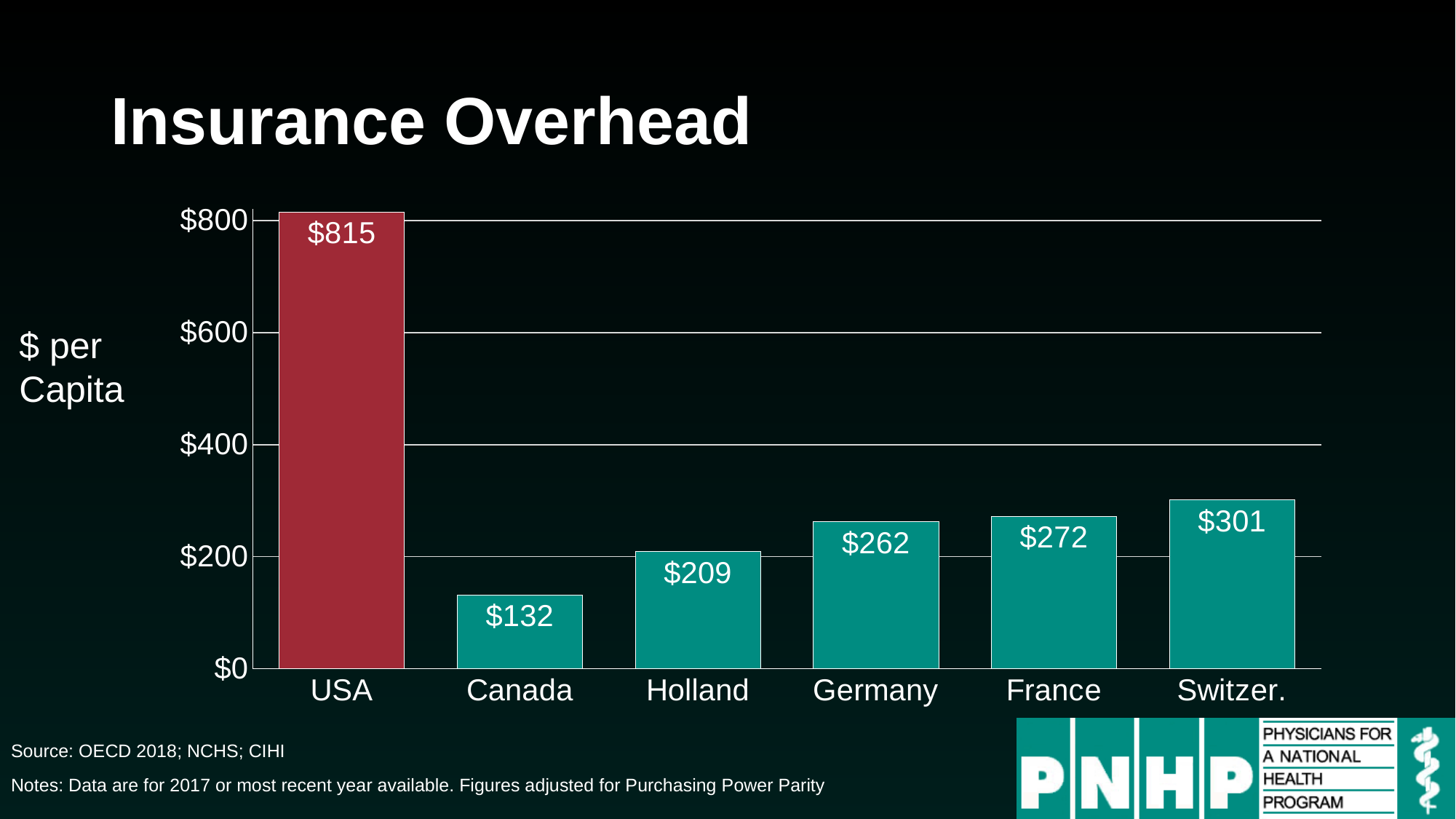
What kind of chart is shown on the slide? Bar chart Which country has the highest insurance overhead per capita? USA What is the insurance overhead per capita for Canada? $132 What is the insurance overhead per capita for Germany? $262 What is the insurance overhead per capita for the USA? $815 How many countries are shown in the chart? 6 Which has a higher insurance overhead per capita, Holland or Germany? Germany Which country has the lowest insurance overhead per capita? Canada What is the difference in insurance overhead per capita between Switzerland and France? $29 Is the value for France greater or less than $200? greater What is the title of the chart? Insurance Overhead What is the difference in insurance overhead per capita between the USA and Canada? $683